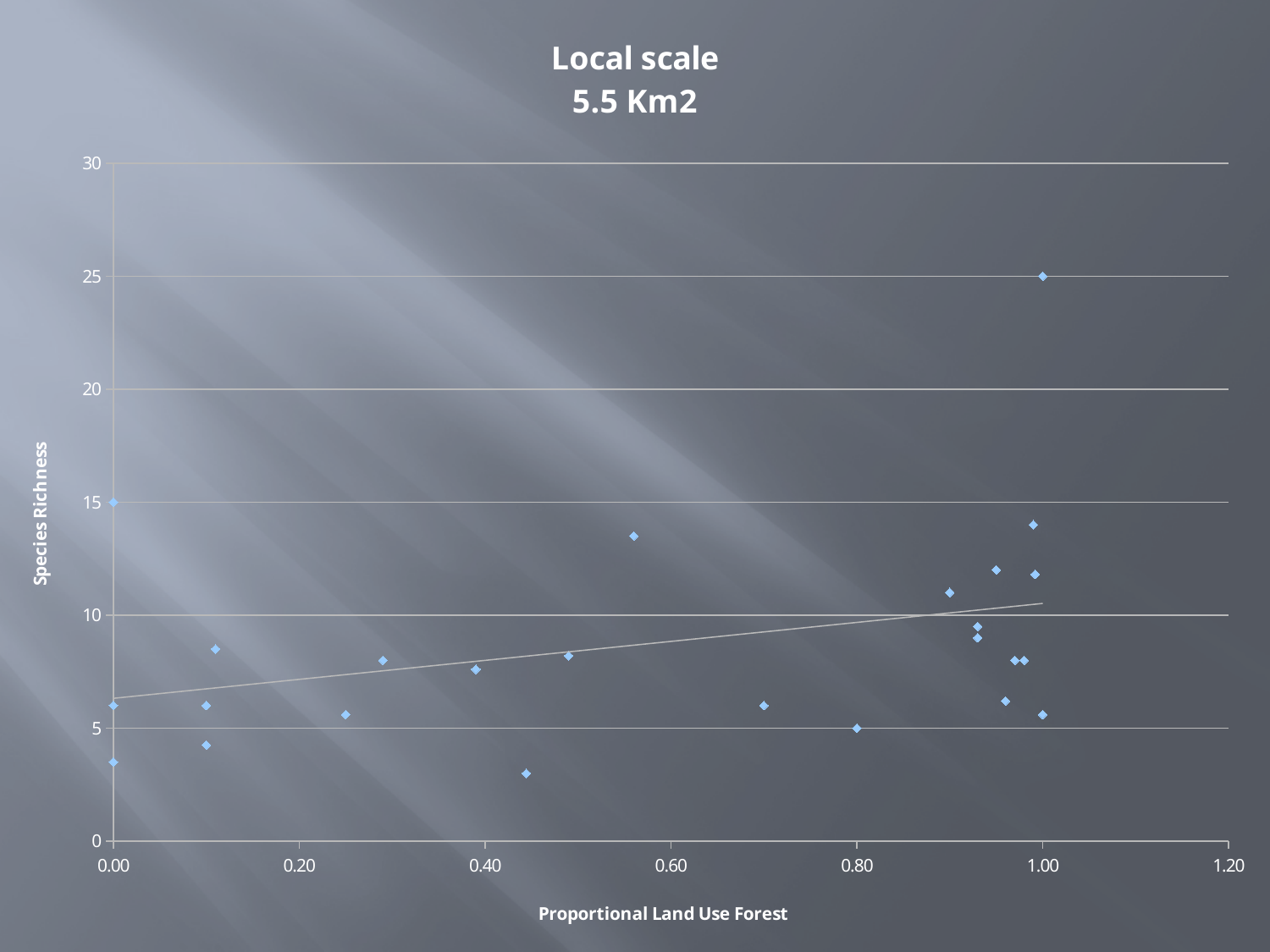
Does the trendline rise or fall as Proportional Land Use Forest increases? rises Is the Species Richness of the point at Proportional Land Use Forest 0.90 greater or less than 10? greater What is the highest Species Richness value plotted on the chart? 25 What is the label of the vertical axis? Species Richness What is the maximum value shown on the vertical axis? 30 What is the Species Richness of the point plotted at Proportional Land Use Forest 0.80? 5 Is the Species Richness of the lowest point on the chart greater or less than 5? less Is the Species Richness of the point at Proportional Land Use Forest 0.56 greater or less than 10? greater What is the Species Richness of the highest point plotted at Proportional Land Use Forest 0.00? 15 Which has the higher Species Richness: the point at Proportional Land Use Forest 0.56 or the point at 0.70? the point at 0.56 What kind of chart is shown on the slide? scatter chart What is the title of the chart? Local scale 5.5 Km2